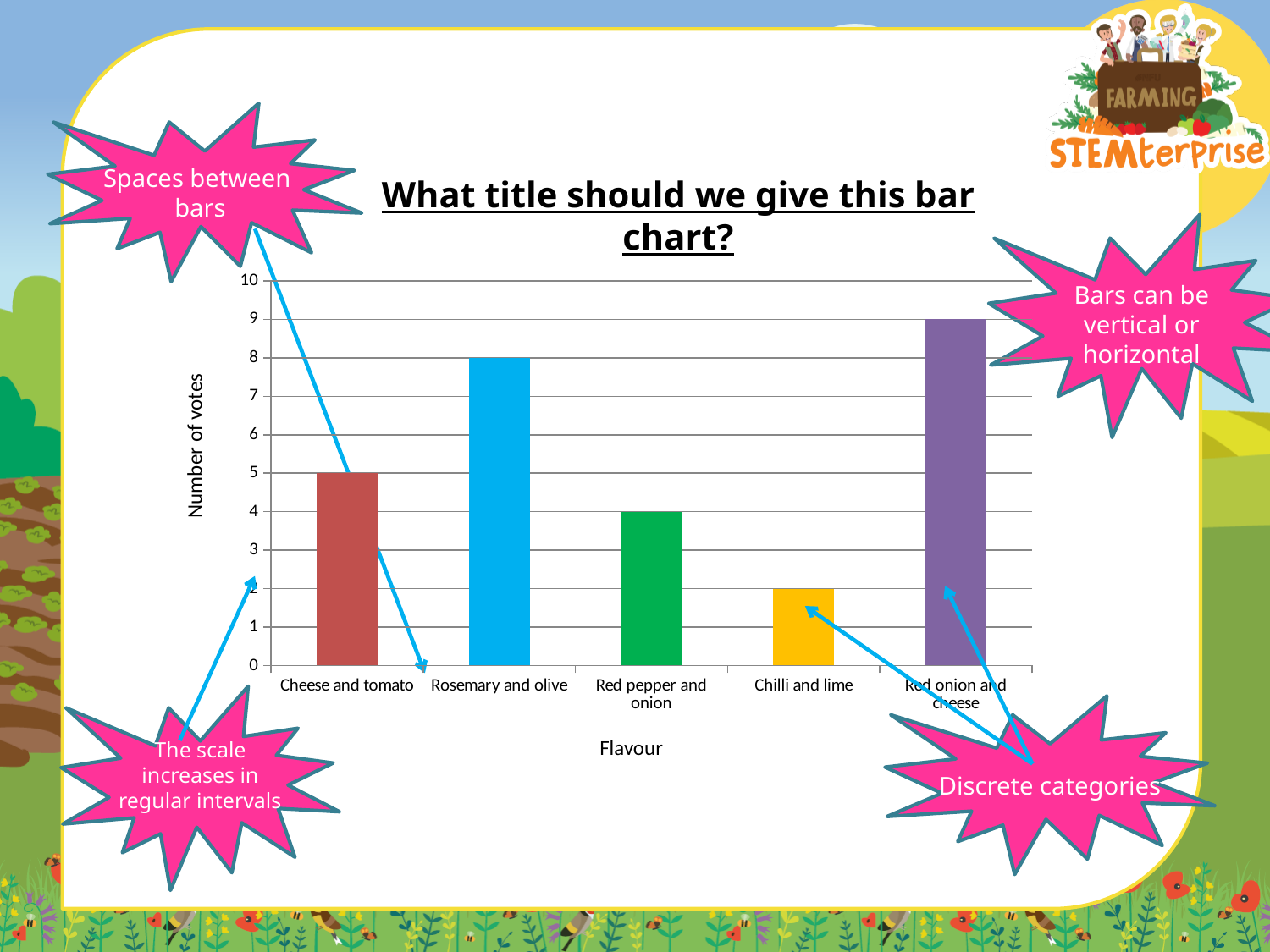
Which flavour received the most votes? Red onion and cheese How many votes did Rosemary and olive receive? 8 How many votes did Chilli and lime receive? 2 What kind of chart is shown on the slide? bar chart What is the label on the horizontal axis of the chart? Flavour Which received more votes, Cheese and tomato or Red pepper and onion? Cheese and tomato How many flavours are shown on the x axis of the chart? 5 Is the value for Rosemary and olive greater or less than 6? greater Which flavour received the fewest votes? Chilli and lime What is the difference in votes between Red onion and cheese and Red pepper and onion? 5 How many votes did Cheese and tomato receive? 5 What is the label on the vertical axis of the chart? Number of votes